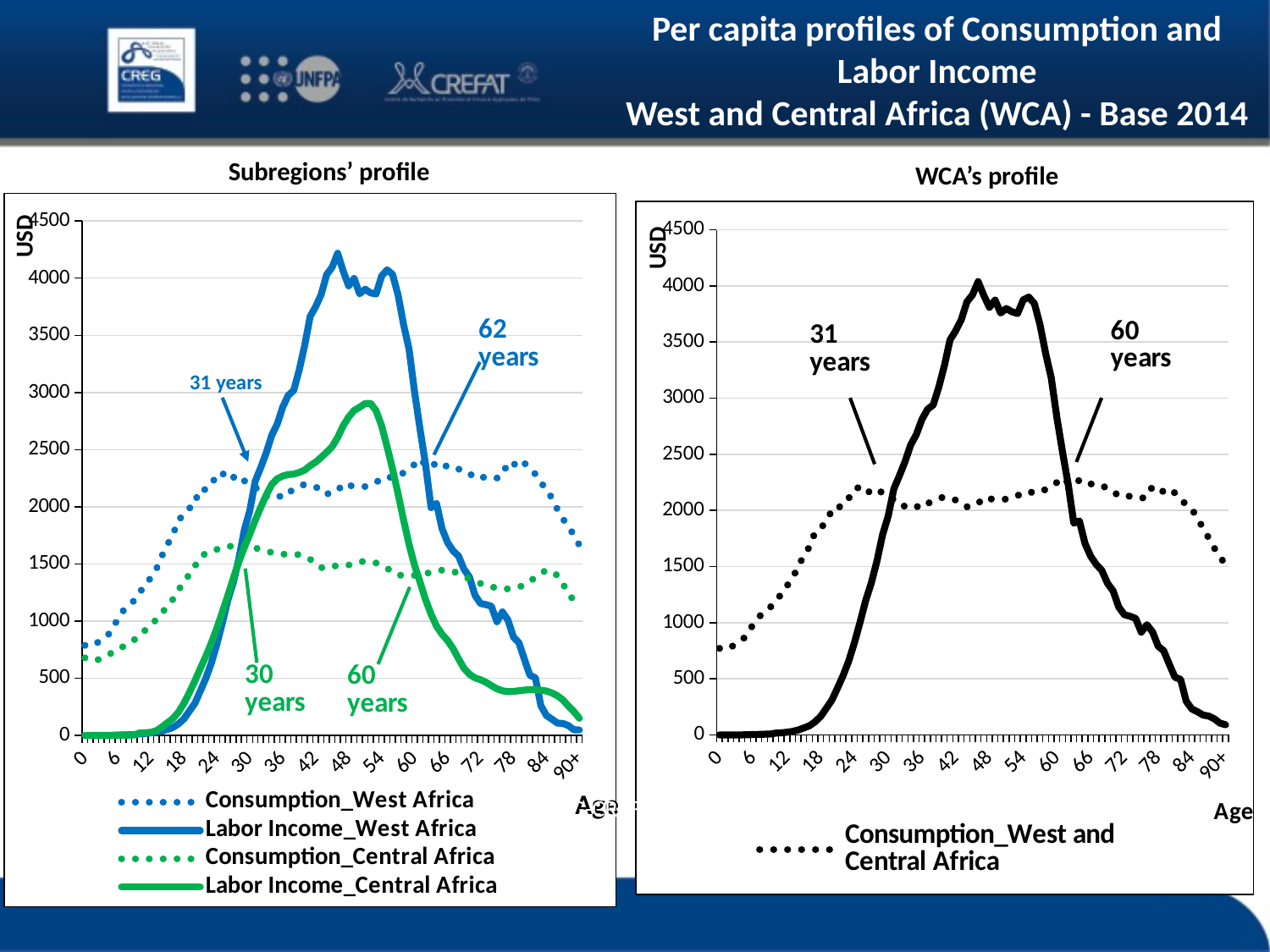
In the 'WCA's profile' chart, is the peak value of the solid labor income line greater or less than 3500? greater In the 'Subregions' profile' chart, is the peak value of Labor Income_Central Africa greater or less than 3000? less In the 'WCA's profile' chart, is the consumption value at age 0 greater or less than 1000? less In the 'Subregions' profile' chart, at what age does the annotation mark the first crossing of labor income and consumption for West Africa? 31 years In the 'Subregions' profile' chart, at age 48, which is higher: Labor Income_West Africa or Labor Income_Central Africa? Labor Income_West Africa In the 'Subregions' profile' chart, does Labor Income_West Africa rise or fall between age 60 and age 90+? fall In the 'WCA's profile' chart, what two ages are annotated on the chart? 31 years and 60 years In the 'Subregions' profile' chart, what two ages are annotated for Central Africa? 30 years and 60 years In the 'Subregions' profile' chart, at what age does the annotation mark the second crossing of labor income and consumption for West Africa? 62 years How many series does the legend of the 'Subregions' profile' chart list? 4 What kind of chart is the 'Subregions' profile' chart? line chart